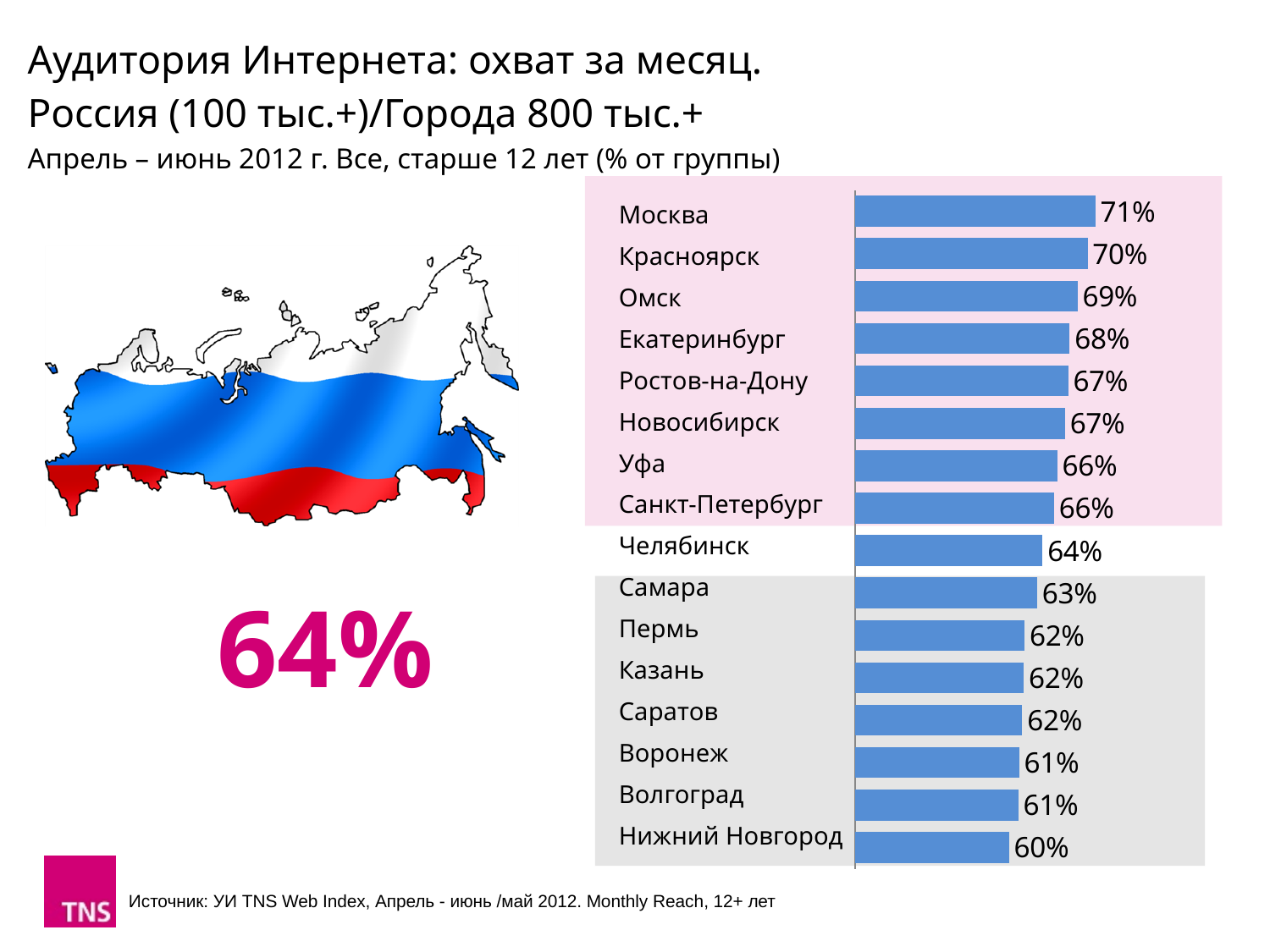
What is the value for Екатеринбург? 68% What is the difference between the values for Омск and Пермь? 7% What is the value for Нижний Новгород? 60% How many cities are shown in the chart? 16 What is the difference between the values for Москва and Нижний Новгород? 11% Which city has the lowest value? Нижний Новгород Which is larger, the value for Красноярск or the value for Самара? Красноярск What large percentage is printed below the map of Russia on the left of the slide? 64% What is the value for Москва? 71% Which city has the highest value? Москва What is the value for Челябинск? 64% What kind of chart is shown on the slide? bar chart